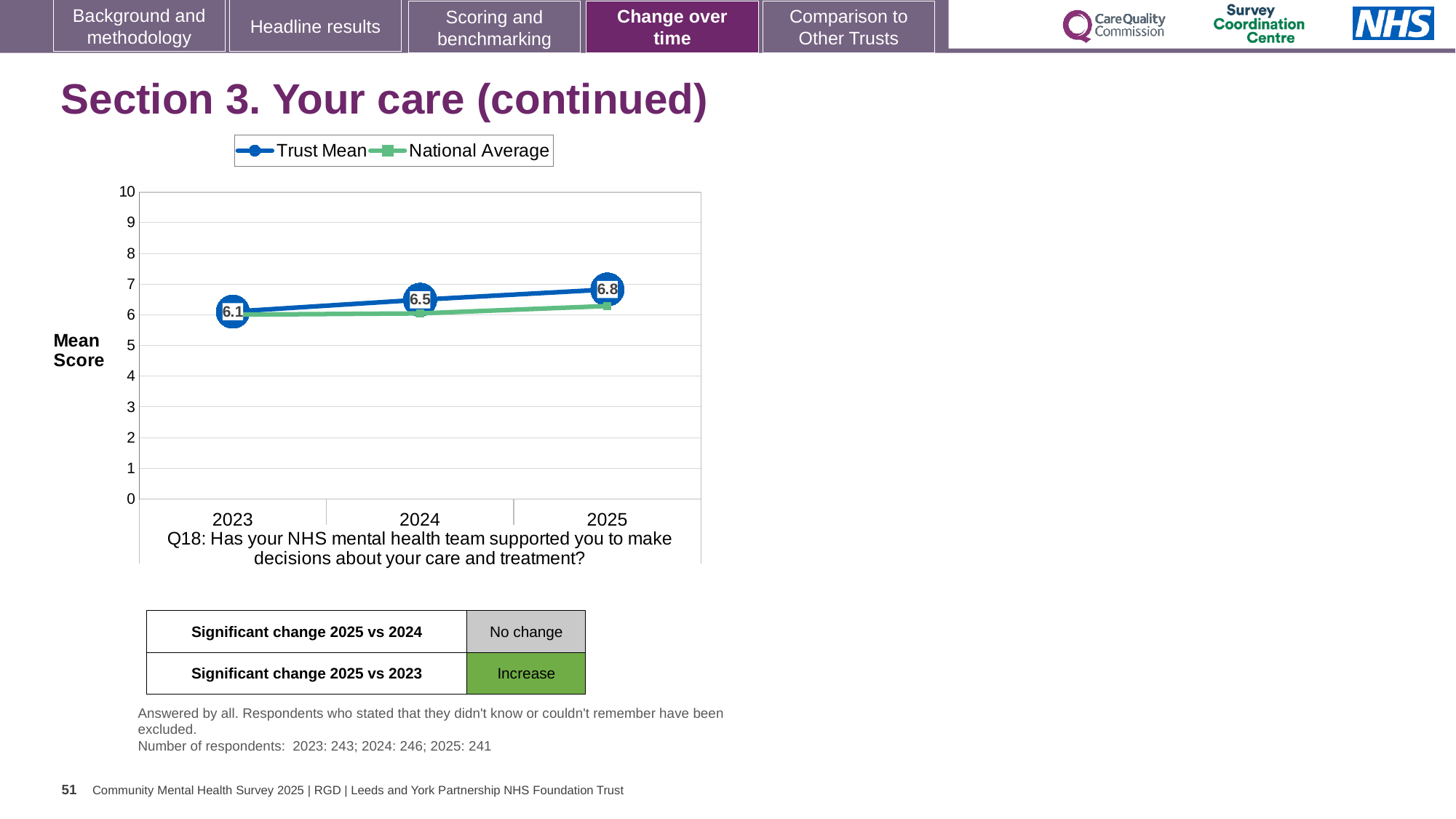
Does the Trust Mean rise or fall from 2023 to 2025? rise In which year is the Trust Mean highest? 2025 Which is larger in 2025, the Trust Mean or the National Average? Trust Mean Is the National Average value for 2025 greater or less than 7? less How many series does the legend list? 2 In which year is the Trust Mean lowest? 2023 What kind of chart is shown on the slide? line chart What is the Trust Mean value for 2025? 6.8 What is the Trust Mean value for 2023? 6.1 How many years are shown on the x axis? 3 What is the Trust Mean value for 2024? 6.5 What is the difference between the Trust Mean in 2025 and in 2023? 0.7